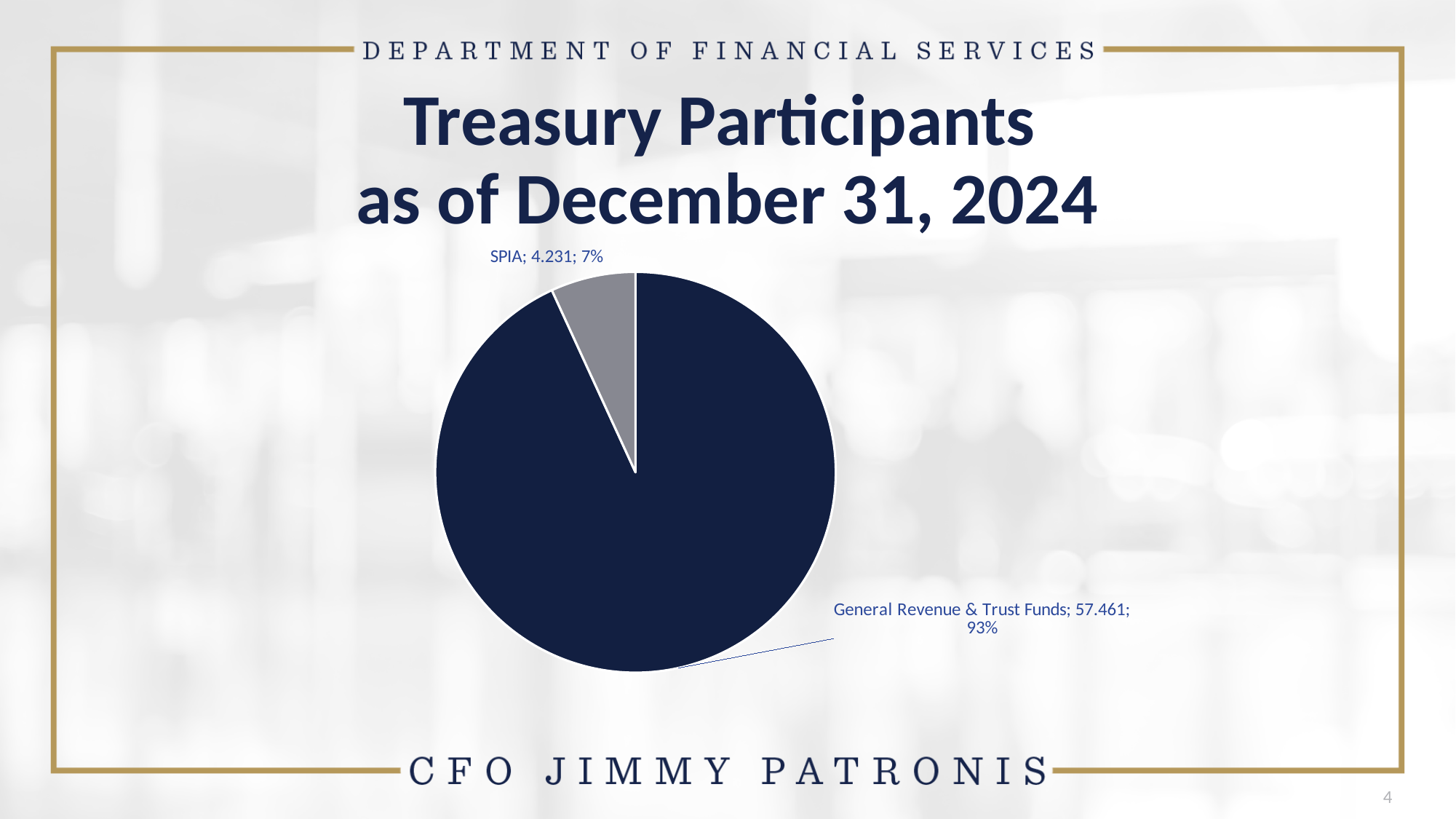
Which category has the smallest slice of the pie? SPIA What kind of chart is shown on the slide? Pie chart What colour is the SPIA slice of the pie? Grey Which category has the largest slice of the pie? General Revenue & Trust Funds What share of the pie does SPIA represent? 7% Which is larger, the value for SPIA or the value for General Revenue & Trust Funds? General Revenue & Trust Funds What is the value for SPIA? 4.231 What is the value for General Revenue & Trust Funds? 57.461 What is the title of the slide containing the chart? Treasury Participants as of December 31, 2024 What share of the pie does General Revenue & Trust Funds represent? 93% What is the difference between the values for General Revenue & Trust Funds and SPIA? 53.230 How many slices does the pie chart have? 2